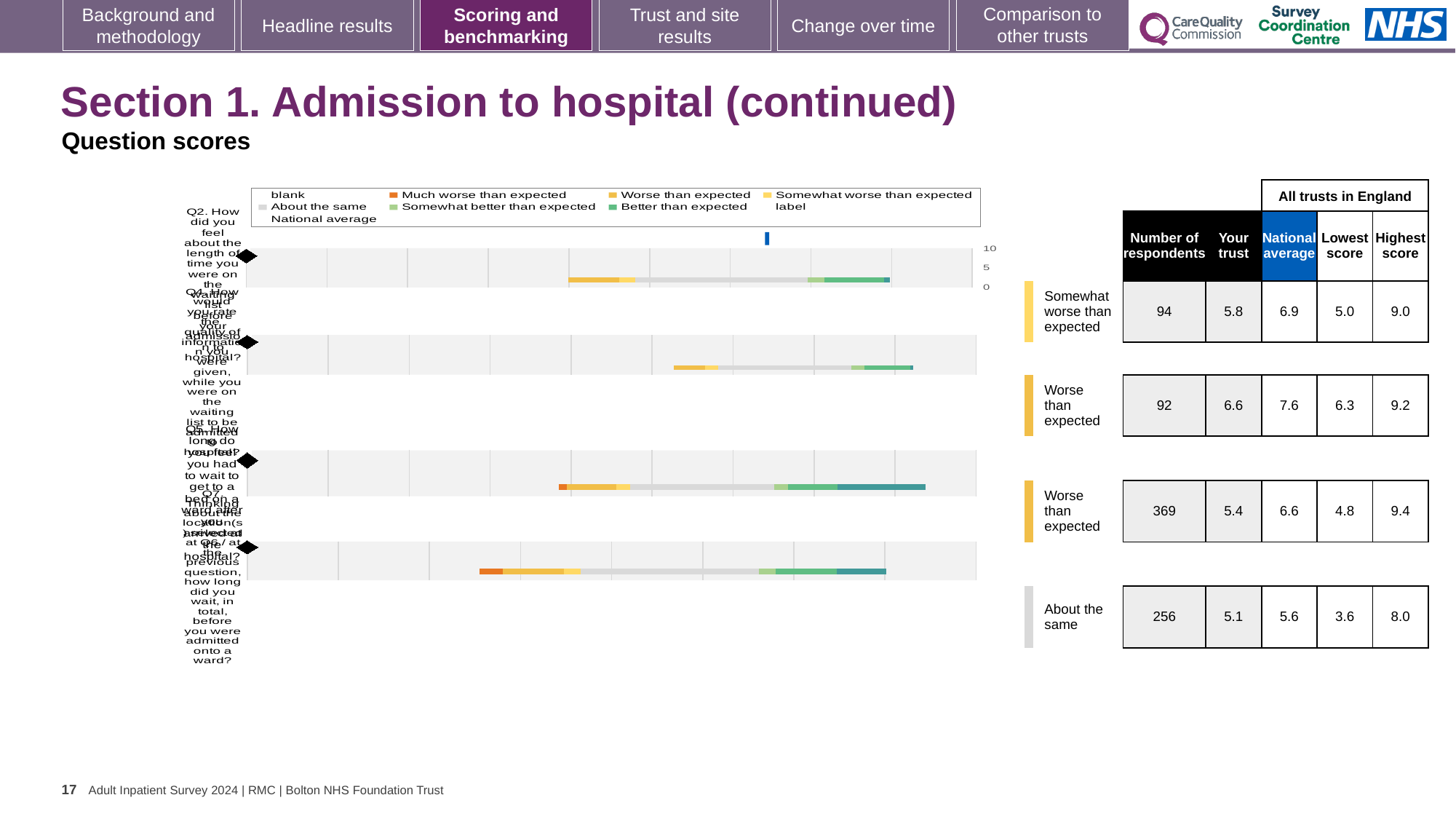
In the table, what is the 'Your trust' score for the first row (Somewhat worse than expected)? 5.8 Which table row has the highest number of respondents? Worse than expected (369) What is the difference between the national average and 'Your trust' score in the first row (Somewhat worse than expected)? 1.1 How many question bars are plotted in the chart? 4 Is the 'Your trust' score in the 'About the same' row larger or smaller than its national average? smaller In the table, what is the national average for the row labelled 'About the same'? 5.6 In the table, what is the number of respondents for the third row (Worse than expected, 369 respondents row)? 369 What is the maximum value shown on the chart's score axis? 10 Which table row has the lowest 'Your trust' score? About the same In the table, what is the highest score for the second row (Worse than expected, 92 respondents)? 9.2 Which legend entry is shown in dark orange? Much worse than expected What kind of chart is shown on the slide? bar chart